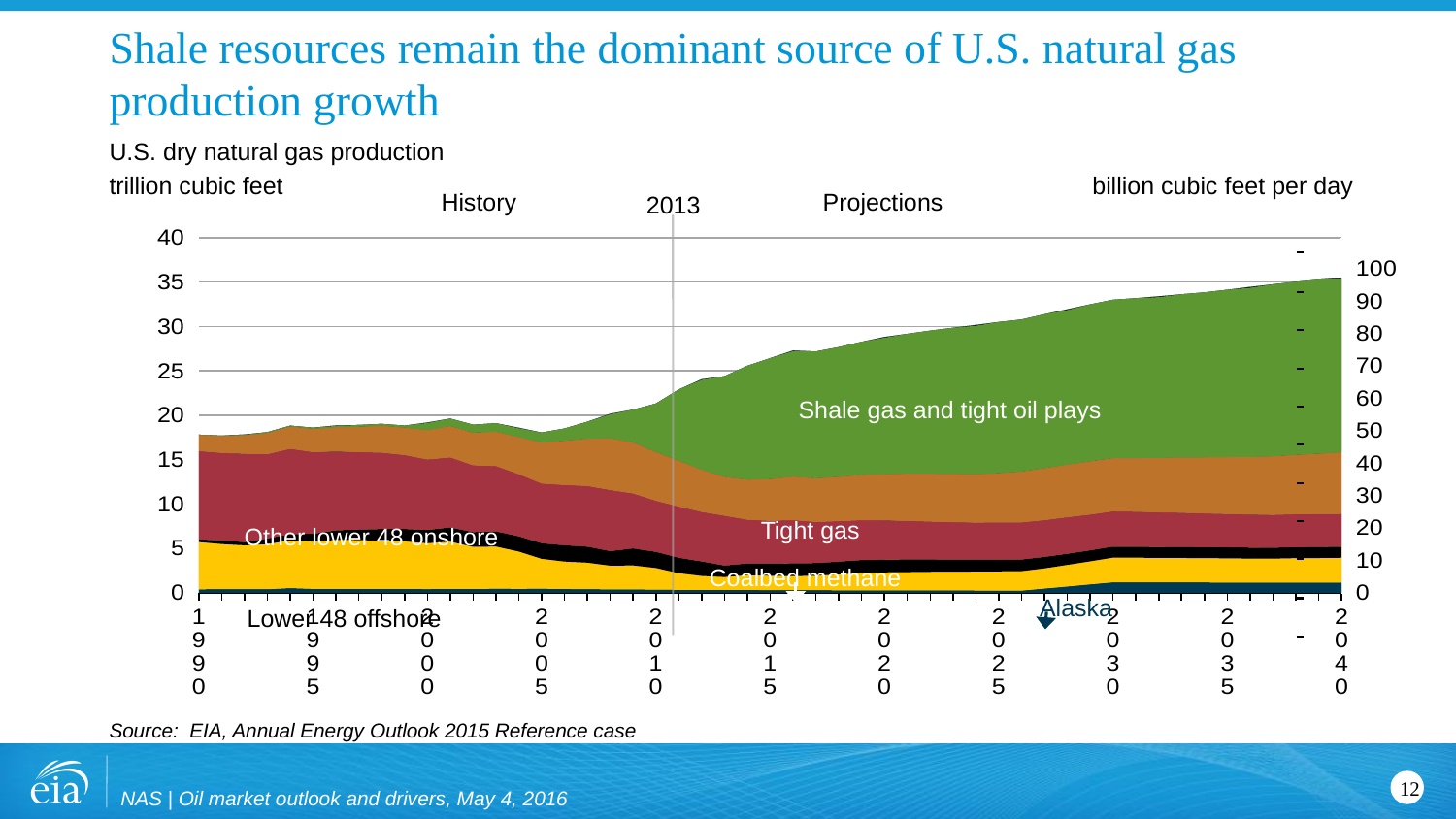
Does the Shale gas and tight oil plays area grow or shrink from 2005 to 2040? grow What kind of chart is shown on the slide? Stacked area chart How many year labels are shown on the x axis? 11 Is total U.S. dry natural gas production in 2040 greater or less than 30 trillion cubic feet? greater Which production category is the largest in 2040? Shale gas and tight oil plays How many production categories (series) are labeled in the chart? 6 Does total U.S. dry natural gas production rise or fall over the projection period after 2013? rise Is total U.S. dry natural gas production in 1990 greater or less than 20 trillion cubic feet? less What unit is shown on the right-hand axis of the chart? billion cubic feet per day In 2040, which is larger: Shale gas and tight oil plays or Tight gas? Shale gas and tight oil plays Which year separates History from Projections in the chart? 2013